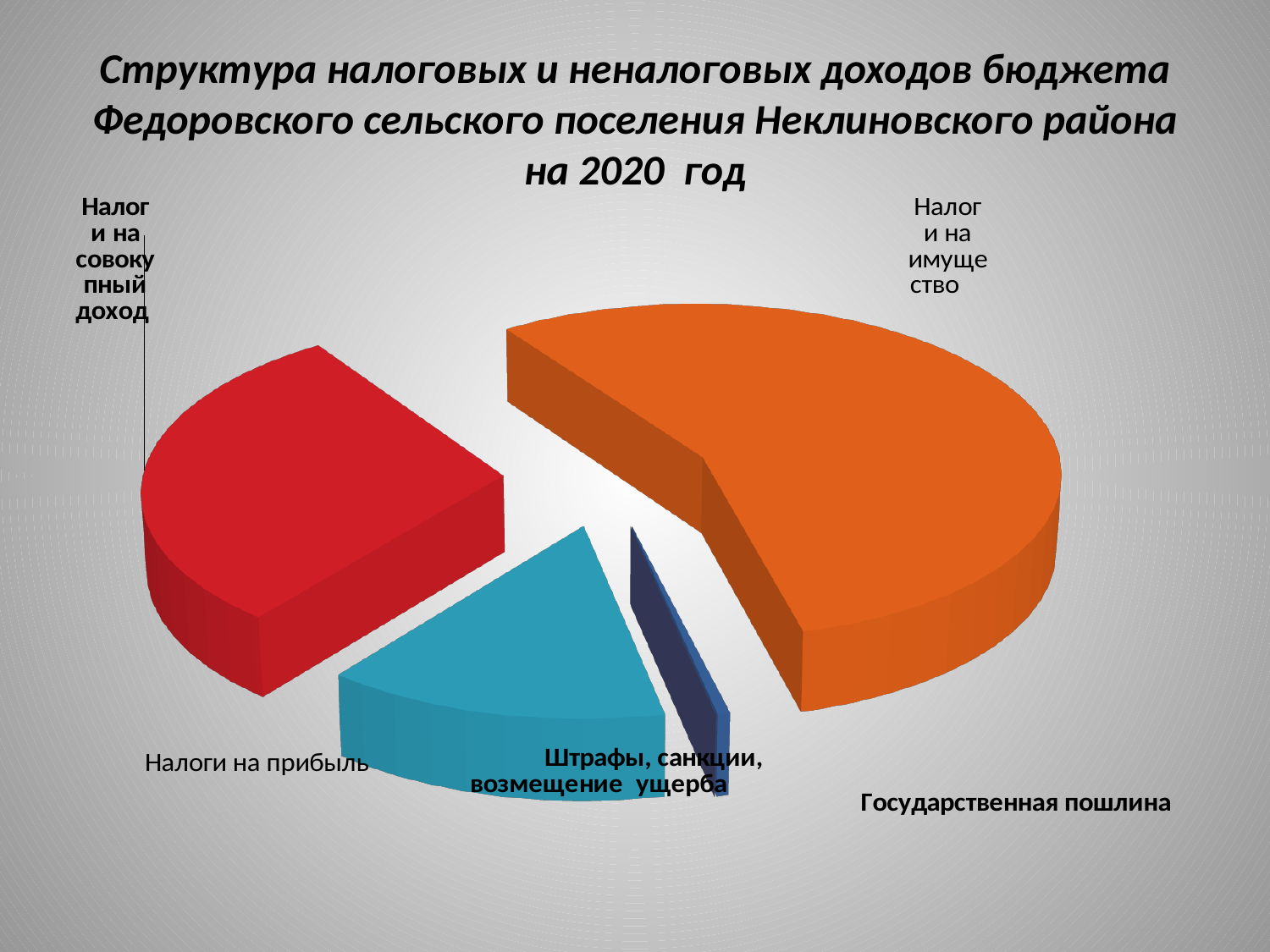
Which category has the largest slice of the pie? Налог на имущество How many categories are labelled on the pie chart? 5 What kind of chart is shown on the slide? pie chart Which is larger: the slice for Налог на имущество or the slice for Налог на совокупный доход? Налог на имущество What colour is the slice for Налог на имущество? orange For which year does the chart show the budget revenue structure? 2020